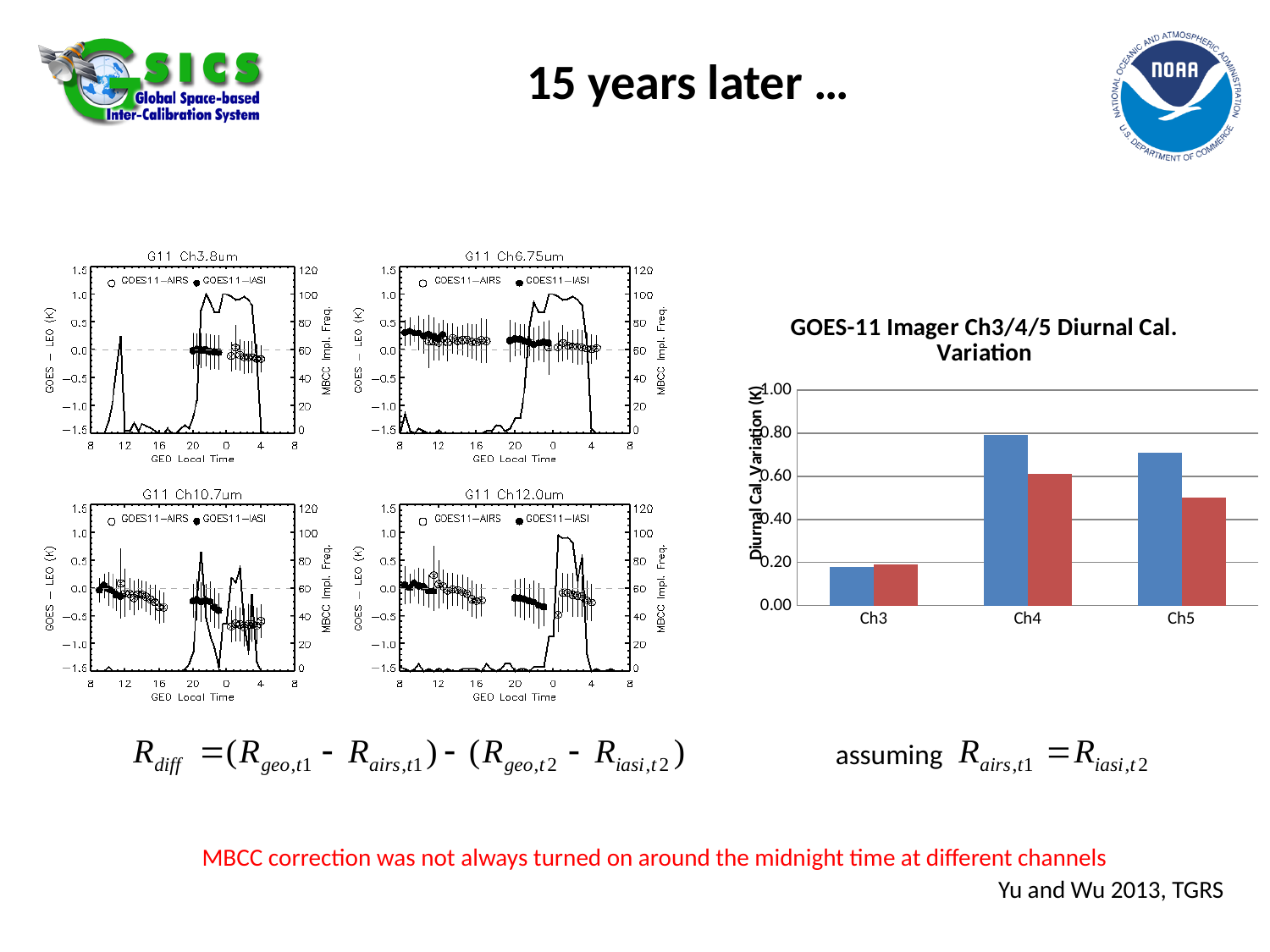
What is the y-axis label of the 'GOES-11 Imager Ch3/4/5 Diurnal Cal. Variation' bar chart? Diurnal Cal Variation (K) In the 'GOES-11 Imager Ch3/4/5 Diurnal Cal. Variation' bar chart, is the blue bar for Ch4 greater or less than 0.60? greater In the 'GOES-11 Imager Ch3/4/5 Diurnal Cal. Variation' bar chart, which channel has the tallest blue bar? Ch4 In the 'GOES-11 Imager Ch3/4/5 Diurnal Cal. Variation' bar chart, is the red bar for Ch5 greater or less than 0.40? greater In the 'GOES-11 Imager Ch3/4/5 Diurnal Cal. Variation' bar chart, is the blue bar for Ch3 greater or less than 0.40? less In the 'GOES-11 Imager Ch3/4/5 Diurnal Cal. Variation' bar chart, which channel has the shortest blue bar? Ch3 In the 'GOES-11 Imager Ch3/4/5 Diurnal Cal. Variation' bar chart, how many bars are plotted for each channel? 2 How many channel categories are shown on the x axis of the 'GOES-11 Imager Ch3/4/5 Diurnal Cal. Variation' bar chart? 3 What type of chart is the 'GOES-11 Imager Ch3/4/5 Diurnal Cal. Variation' chart? bar chart In the 'GOES-11 Imager Ch3/4/5 Diurnal Cal. Variation' bar chart, which is larger: the blue bar for Ch4 or the blue bar for Ch5? Ch4 In the 'GOES-11 Imager Ch3/4/5 Diurnal Cal. Variation' bar chart, for Ch5, which bar is taller, the blue one or the red one? the blue one In the 'GOES-11 Imager Ch3/4/5 Diurnal Cal. Variation' bar chart, which channel has the shortest red bar? Ch3